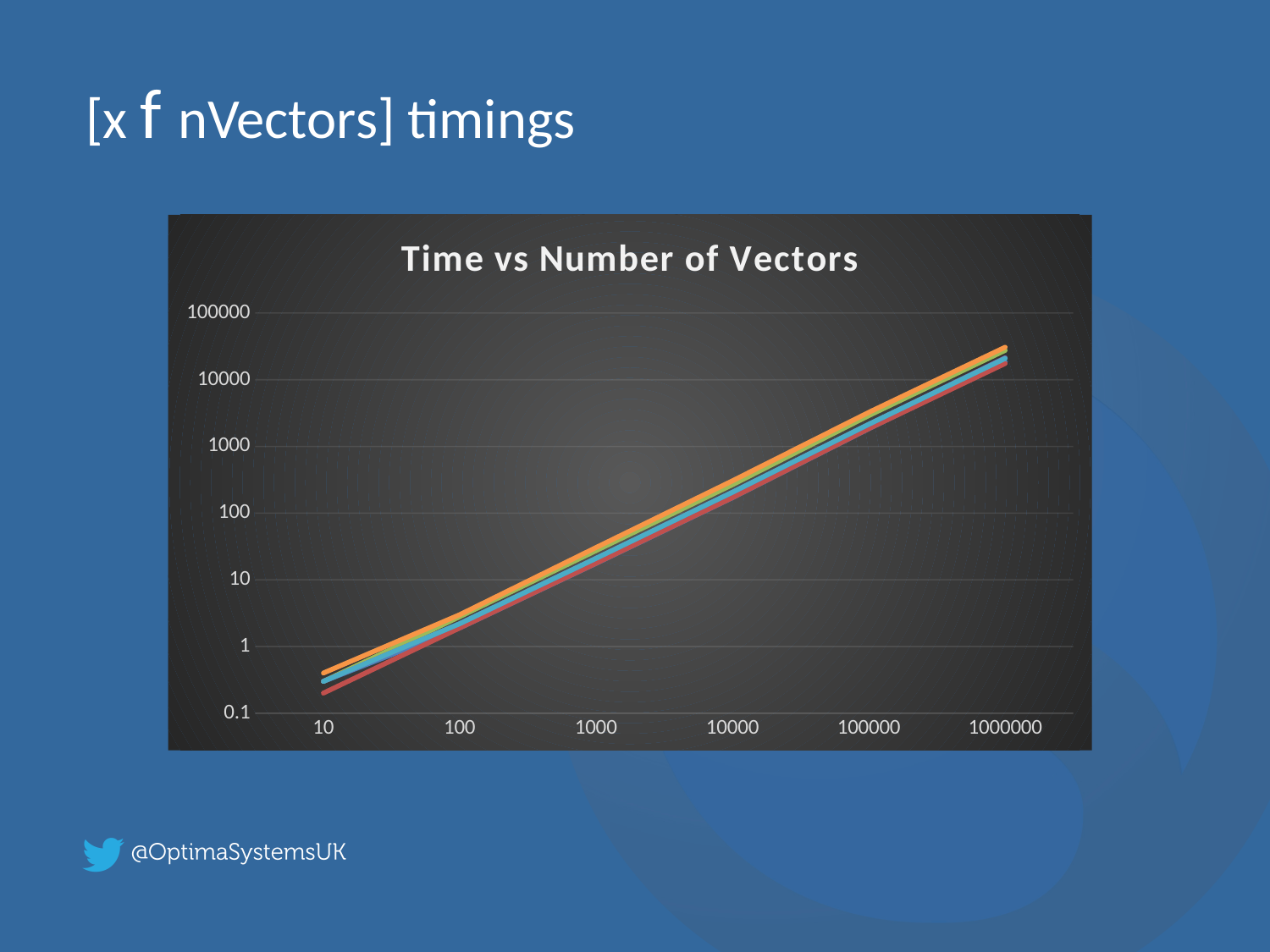
Are the values of the lines at 10000 vectors greater or less than 100? greater Are the values of the lines at 1000000 vectors greater or less than 100000? less Do the plotted lines rise or fall as the number of vectors increases along the x axis? rise Are the values of the lines at 1000000 vectors greater or less than 10000? greater What kind of chart is shown on the slide? line chart What is the highest value labelled on the y axis? 100000 What is the title of the chart? Time vs Number of Vectors How many tick labels are shown on the x axis? 6